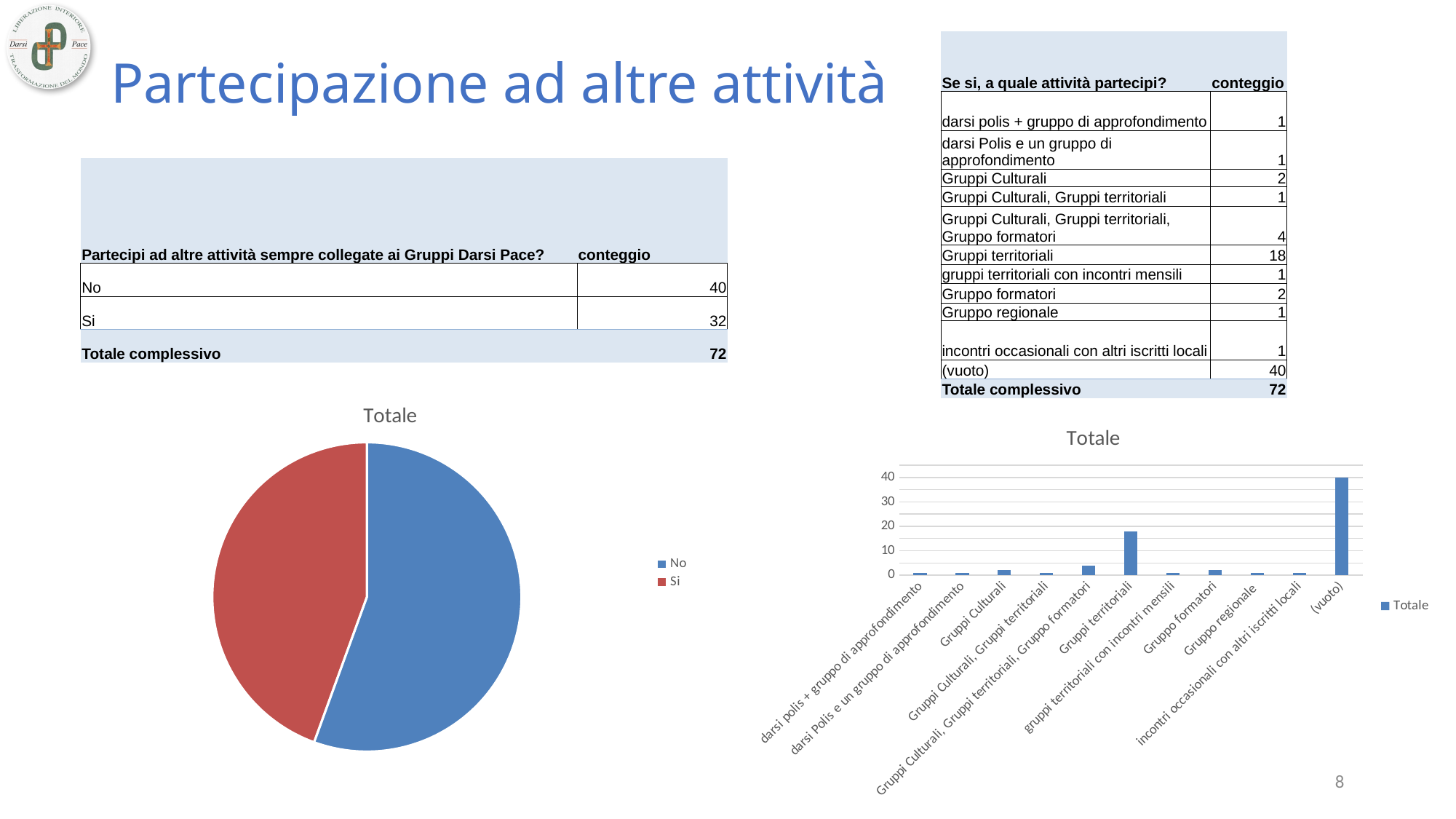
In the pie chart on the left, what is the value for No according to the table above it? 40 What kind of chart is the chart on the left of the slide? pie chart In the pie chart on the left, how many slices are there? 2 In the bar chart on the right, which category has the highest bar? (vuoto) In the pie chart on the left, which slice is larger, No or Si? No What kind of chart is the chart on the right of the slide? bar chart In the bar chart on the right, is the value for Gruppi territoriali greater or less than 10? greater In the pie chart on the left, what is the difference between the No and Si values shown in the table above it? 8 How many series does the legend of the bar chart on the right list? 1 In the bar chart on the right, is the value for Gruppo formatori greater or less than 10? less In the bar chart on the right, which bar is taller, Gruppi territoriali or Gruppi Culturali? Gruppi territoriali In the pie chart on the left, what colour is the Si slice? red